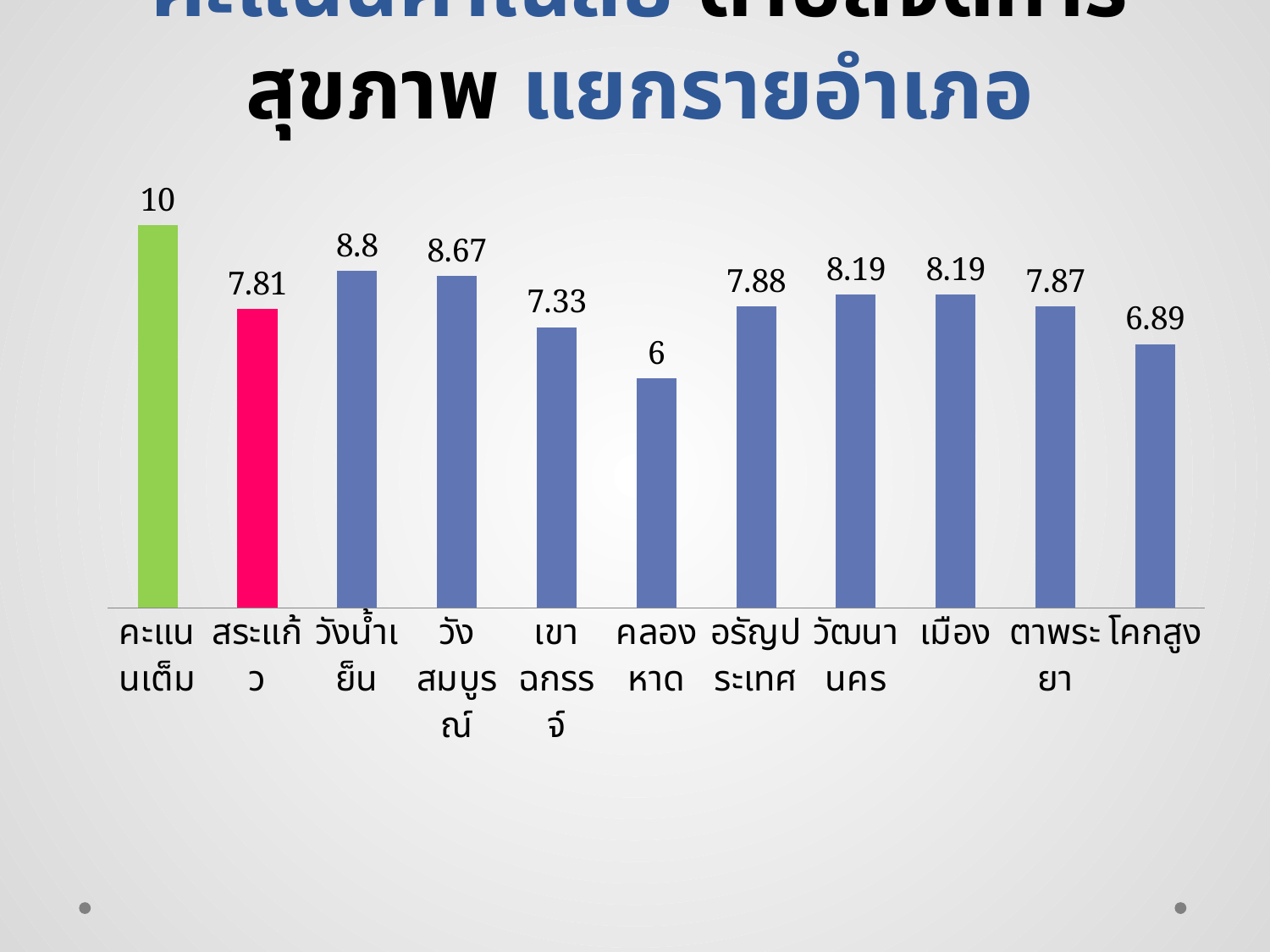
What is the value for วังน้ำเย็น? 8.8 Which category has the lowest value? คลองหาด How many bars are shown in the chart? 11 What is the value for โคกสูง? 6.89 What is the difference between the values for วังน้ำเย็น and คลองหาด? 2.8 Which category has the highest value? คะแนนเต็ม Excluding คะแนนเต็ม, which district has the highest value? วังน้ำเย็น What is the difference between the values for คะแนนเต็ม and สระแก้ว? 2.19 What is the value for สระแก้ว? 7.81 Which is larger, the value for วังสมบูรณ์ or the value for เขาฉกรรจ์? วังสมบูรณ์ What is the value for คลองหาด? 6 What type of chart is shown on the slide? bar chart